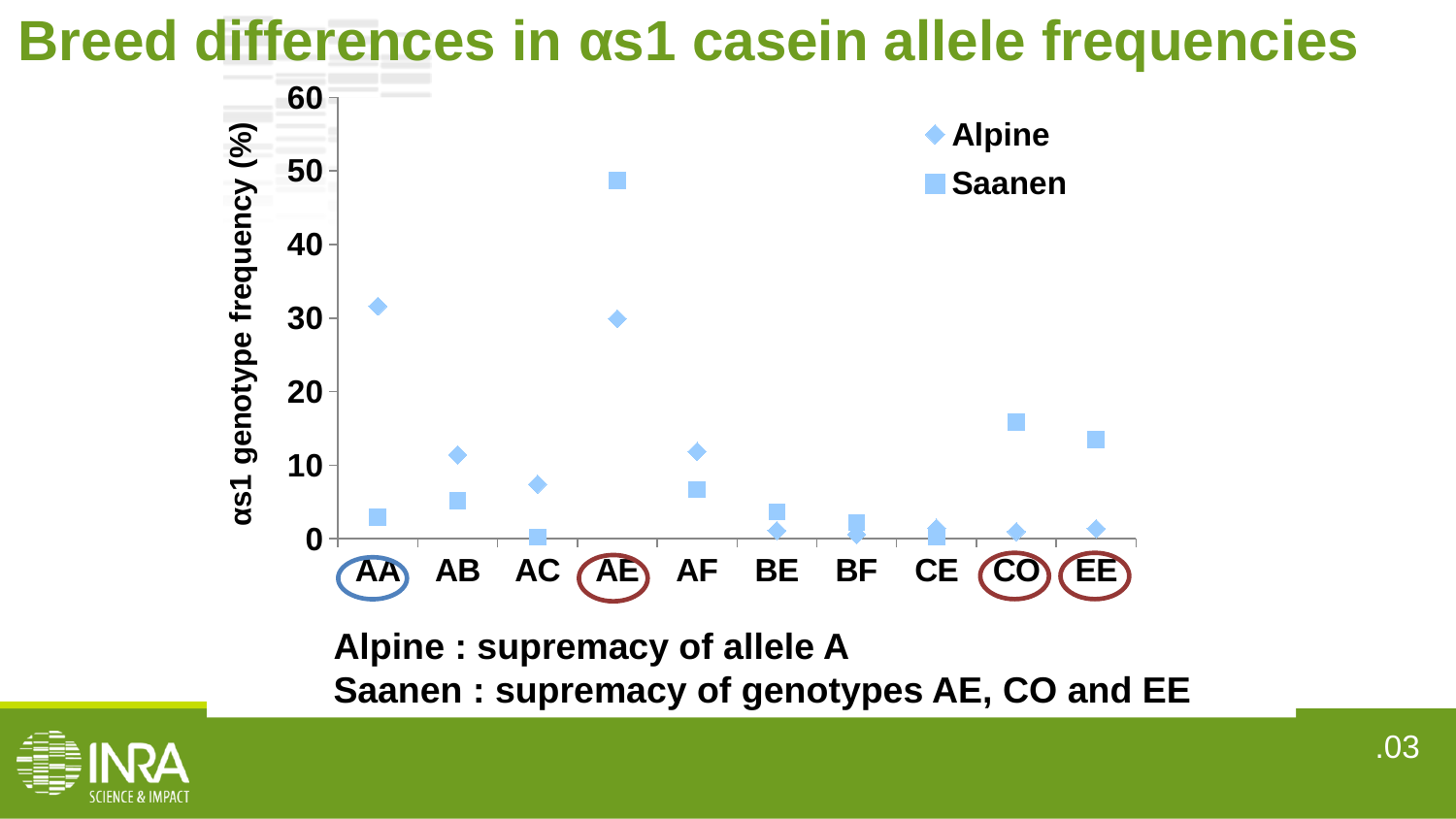
Is the Saanen value for EE greater or less than 10? greater For which genotype is the Saanen value highest? AE For genotype AA, which series has the larger value, Alpine or Saanen? Alpine What is the title of the vertical axis of the chart? αs1 genotype frequency (%) For genotype AE, which series has the larger value, Alpine or Saanen? Saanen How many series does the chart legend list? 2 Is the Saanen value for CO greater or less than 20? less How many genotype categories are shown on the x axis of the chart? 10 Is the Saanen value for AE greater or less than 40? greater Which series are listed in the chart legend? Alpine and Saanen